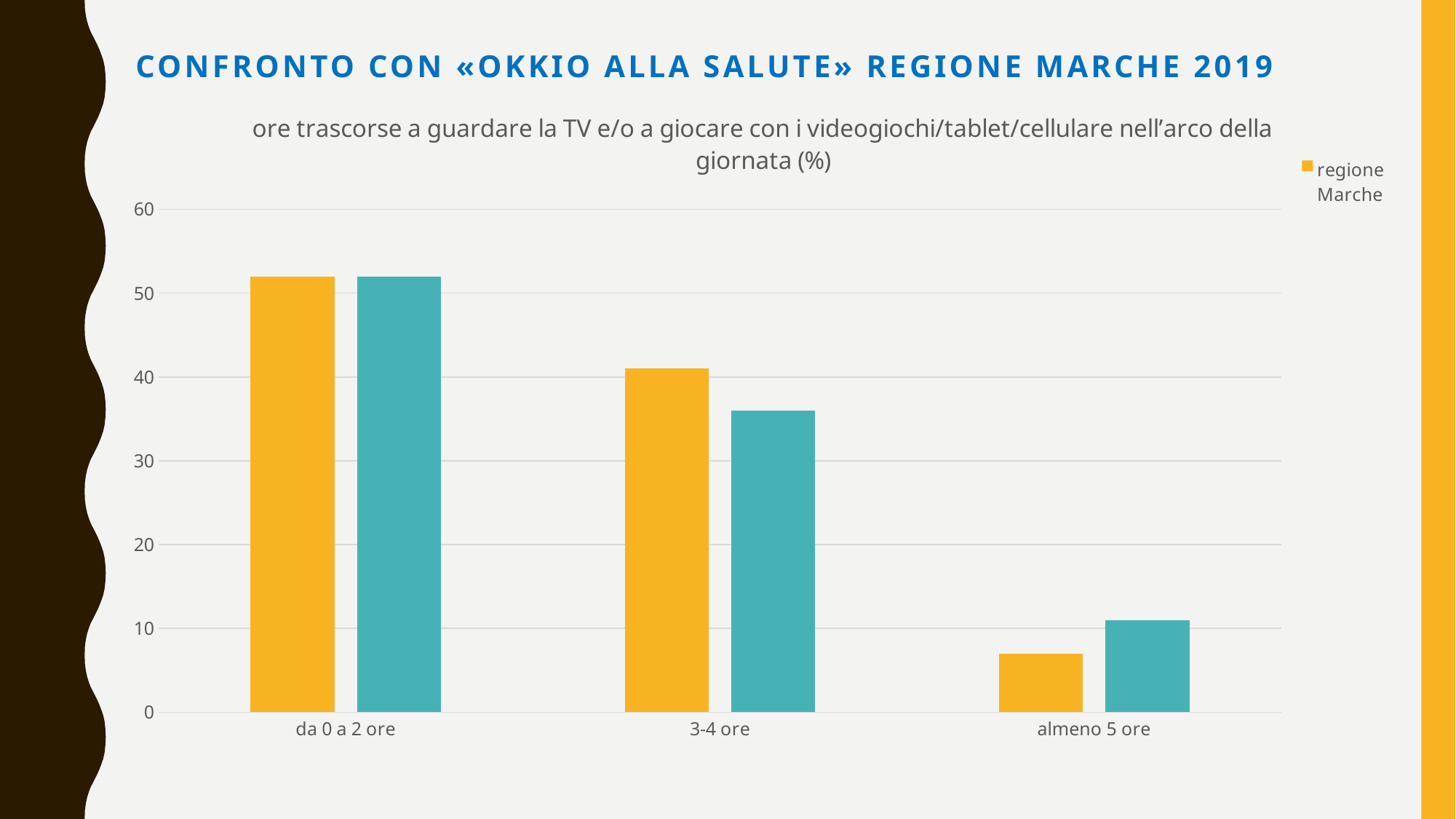
For the category '3-4 ore', which bar is taller, the orange regione Marche bar or the teal bar? the orange regione Marche bar Do the regione Marche values rise or fall moving from 'da 0 a 2 ore' to 'almeno 5 ore'? fall Is the regione Marche value for 'almeno 5 ore' greater or less than 10? less How many categories are shown on the x axis of the chart? 3 Which category has the lowest value for the regione Marche series? almeno 5 ore Which category has the highest value for the regione Marche series? da 0 a 2 ore Is the regione Marche value for 'da 0 a 2 ore' greater or less than 50? greater What kind of chart is shown on the slide? bar chart How many series does the chart's legend list? 1 What is the legend entry shown for the orange bars? regione Marche